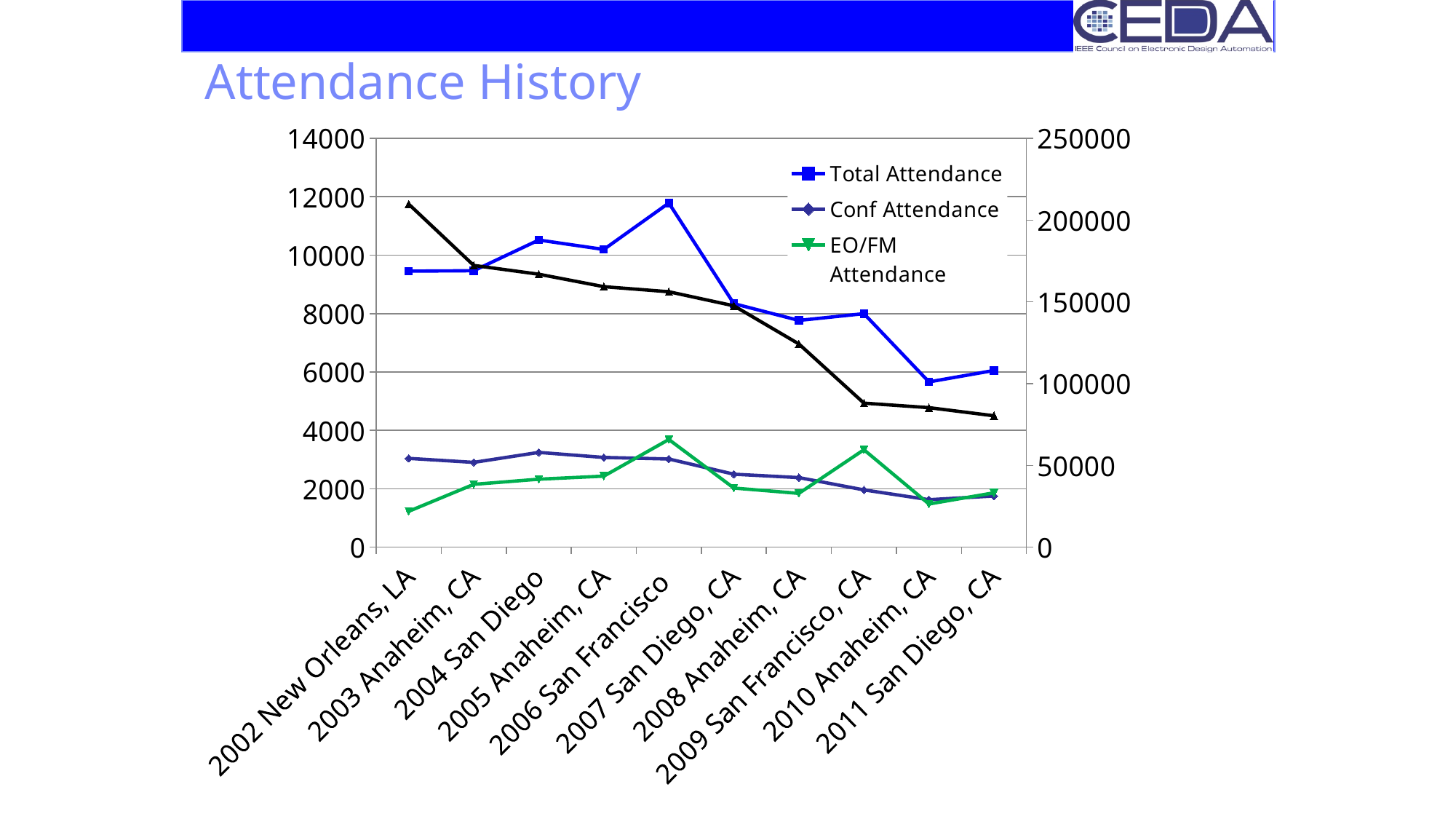
Is the Total Attendance for 2006 San Francisco greater or less than 10000? greater What kind of chart is shown on the slide? line chart How many conference years are plotted along the x axis? 10 Does Total Attendance generally rise or fall from 2002 to 2011? fall Is the EO/FM Attendance for 2002 New Orleans, LA greater or less than 2000? less Which conference has the highest EO/FM Attendance? 2006 San Francisco Which conference has the highest Total Attendance? 2006 San Francisco Which conference has the lowest Total Attendance? 2010 Anaheim, CA Is the Total Attendance for 2010 Anaheim, CA greater or less than 6000? less How many series does the legend list? 3 Which conference has the lowest EO/FM Attendance? 2002 New Orleans, LA Which is larger at 2009 San Francisco, CA: EO/FM Attendance or Conf Attendance? EO/FM Attendance